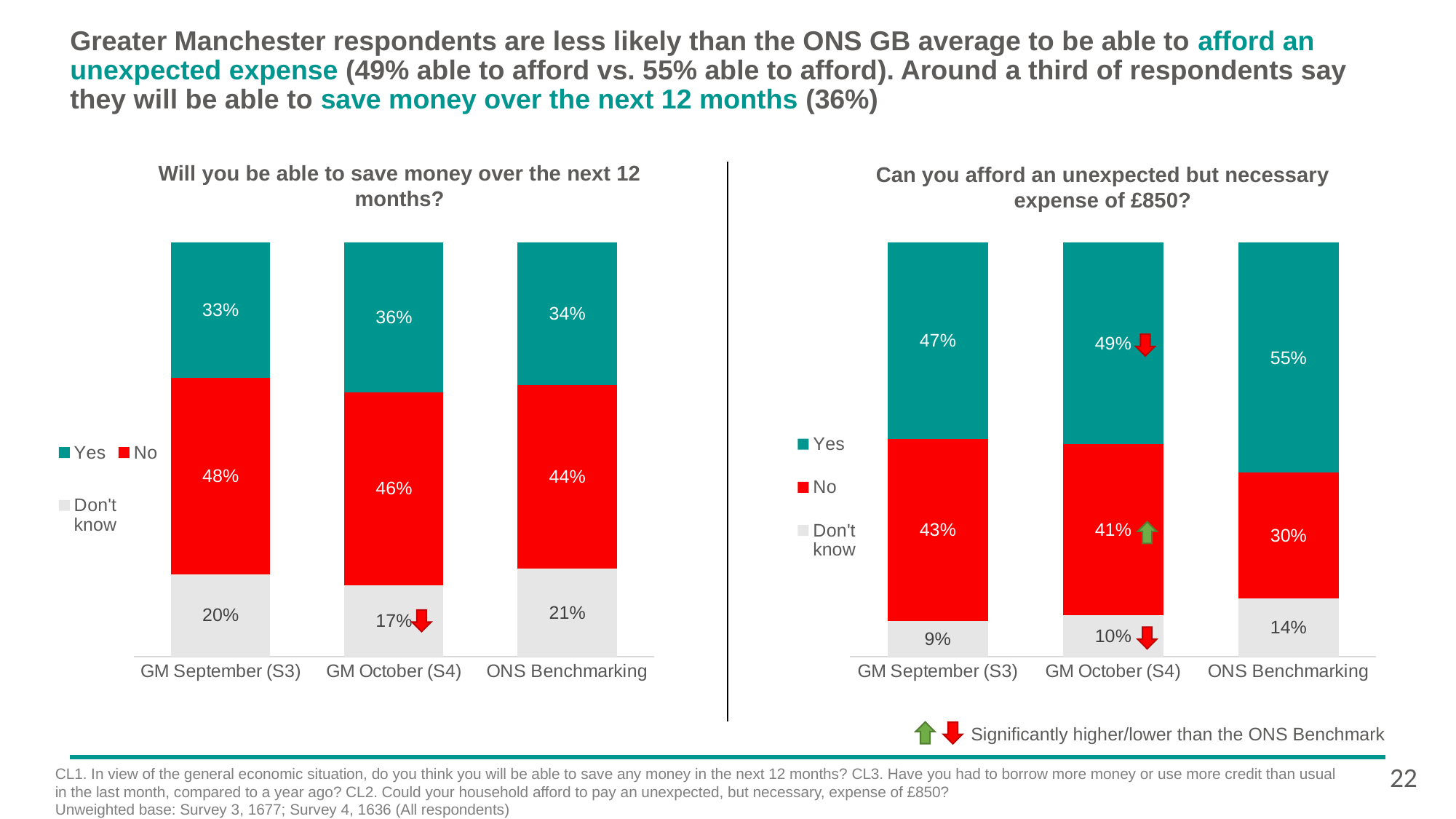
In the chart 'Can you afford an unexpected but necessary expense of £850?', is the 'No' value larger for GM September (S3) or ONS Benchmarking? GM September (S3) In the chart 'Can you afford an unexpected but necessary expense of £850?', what is the 'No' value for ONS Benchmarking? 30% In the chart 'Will you be able to save money over the next 12 months?', what is the 'Don't know' value for ONS Benchmarking? 21% In the chart 'Can you afford an unexpected but necessary expense of £850?', what is the 'Don't know' value for GM September (S3)? 9% How many categories are shown on the x axis of the right chart? 3 How many series does the legend of the left chart list? 3 In the chart 'Can you afford an unexpected but necessary expense of £850?', what is the difference between the 'Yes' values for ONS Benchmarking and GM October (S4)? 6% In the chart 'Will you be able to save money over the next 12 months?', which category has the lowest 'Don't know' value? GM October (S4) In the chart 'Will you be able to save money over the next 12 months?', what is the difference between the 'No' values for GM September (S3) and ONS Benchmarking? 4% What kind of chart is the chart 'Can you afford an unexpected but necessary expense of £850?'? Stacked bar chart In the chart 'Can you afford an unexpected but necessary expense of £850?', which category has the highest 'Yes' value? ONS Benchmarking In the chart 'Will you be able to save money over the next 12 months?', what is the 'Yes' value for GM October (S4)? 36%